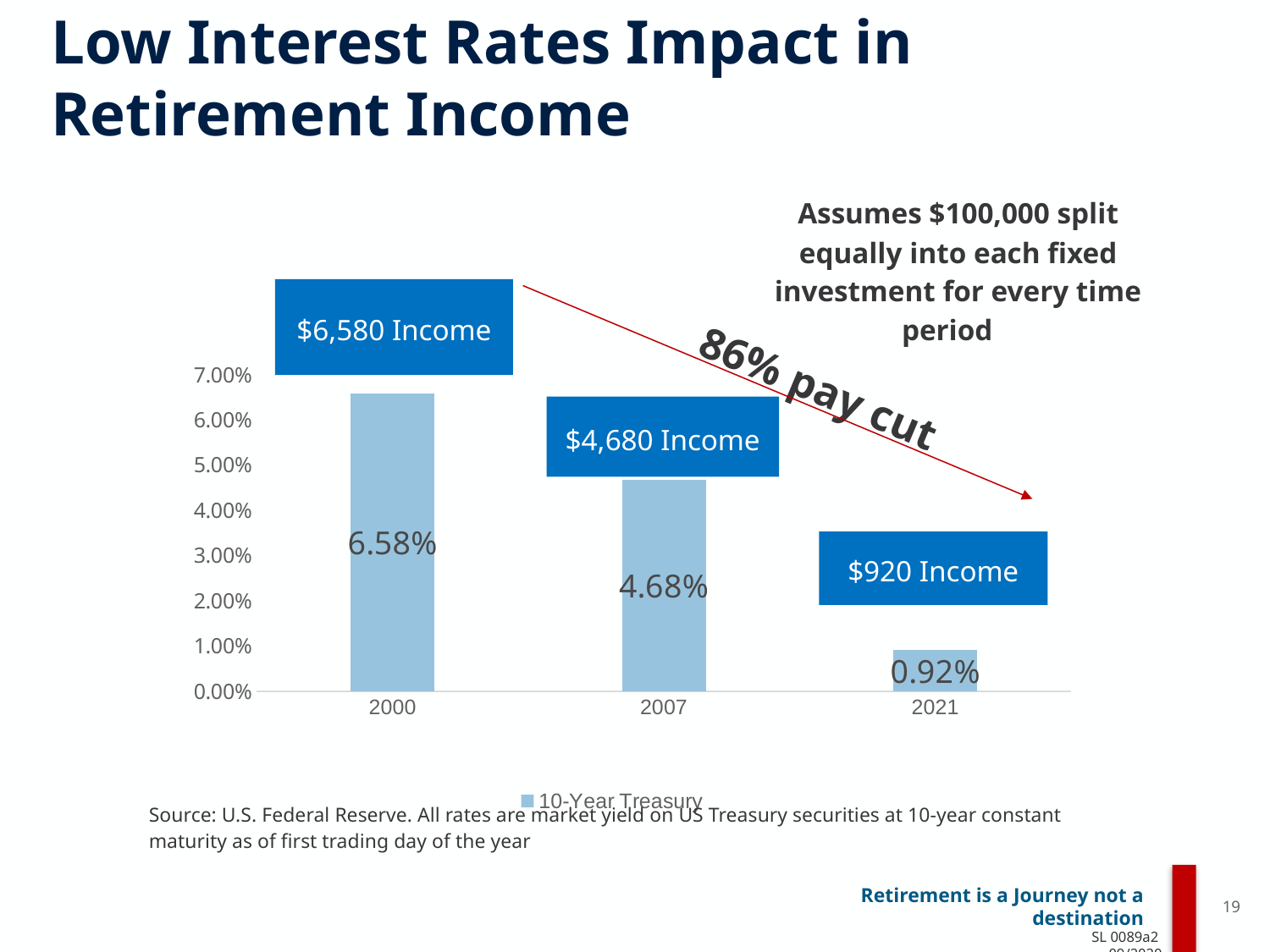
What is the difference between the 2007 yield and the 2021 yield? 3.76% Which year has the highest 10-Year Treasury yield on the chart? 2000 How many years are plotted on the chart? 3 Do the yields rise or fall from 2000 to 2021? fall What is the 10-Year Treasury yield shown for 2021? 0.92% What kind of chart is shown on the slide? bar chart What is the 10-Year Treasury yield shown for 2000? 6.58% Is the yield for 2021 greater or less than 1.00%? less What is the difference between the 2000 yield and the 2007 yield? 1.90% What is the 10-Year Treasury yield shown for 2007? 4.68% Which is larger, the yield for 2007 or the yield for 2021? 2007 Which year has the lowest 10-Year Treasury yield on the chart? 2021